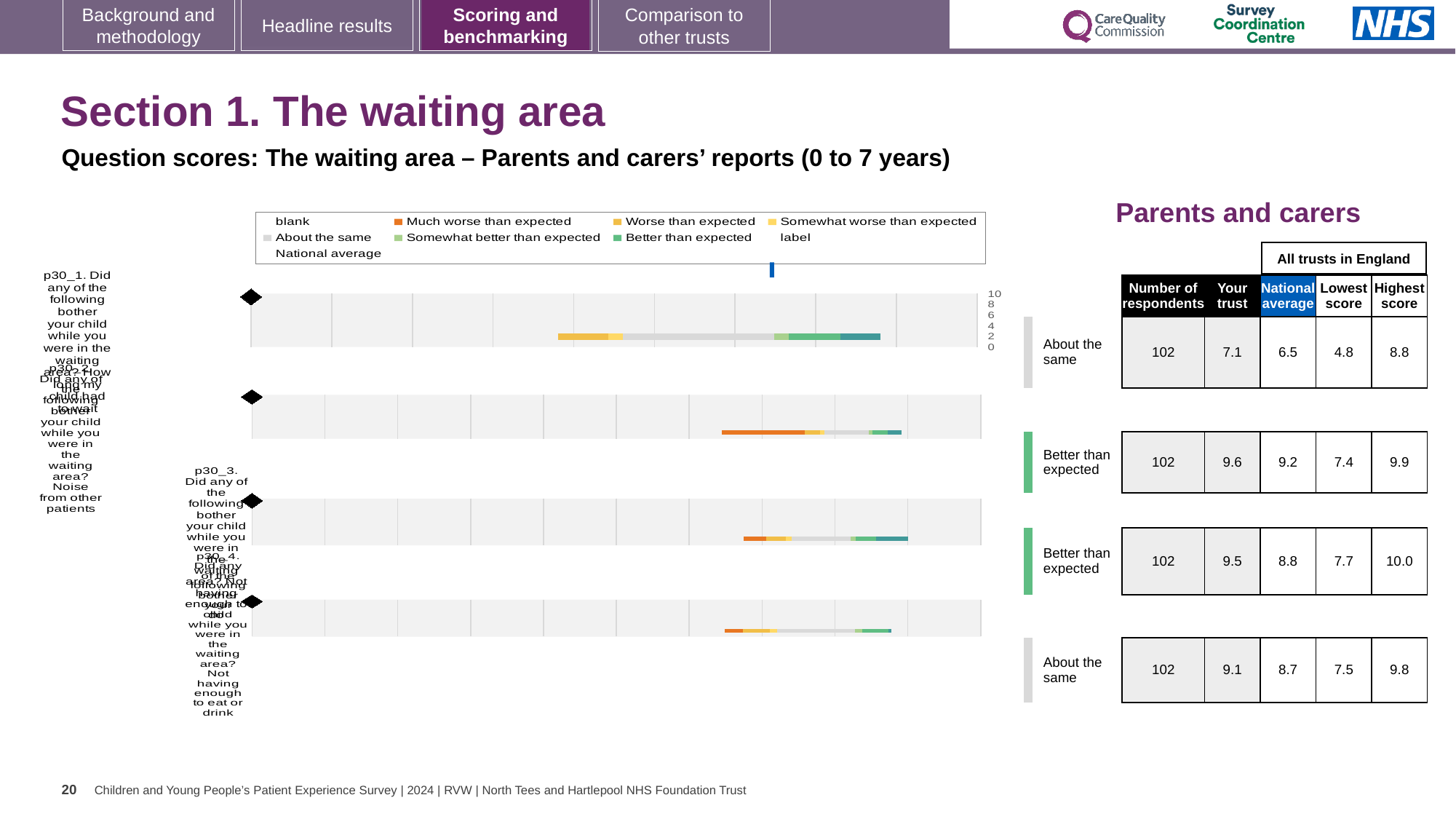
What kind of chart is shown on the slide? bar chart How many entries does the chart legend list? 9 In the table beside the chart, what is the 'Your trust' score for the first row (p30_1, noise from other patients)? 7.1 What is the difference between the 'Your trust' score and the national average for the first row (p30_1) in the table beside the chart? 0.6 How many question rows (bars) does the chart show? 4 In the table beside the chart, what is the national average for the second row (p30_2, how long my child had to wait)? 9.2 What is the maximum value shown on the chart's axis? 10 In the table beside the chart, how many respondents are listed for each question row? 102 In the table beside the chart, what is the highest score for the third row (p30_3, not having enough to do)? 10.0 Which question row has the lowest 'Your trust' score in the table beside the chart? p30_1 (first row), 7.1 Which question row has the highest 'Your trust' score in the table beside the chart? p30_2 (second row), 9.6 In the table beside the chart, what is the lowest score for the fourth row (p30_4, not having enough to eat or drink)? 7.5